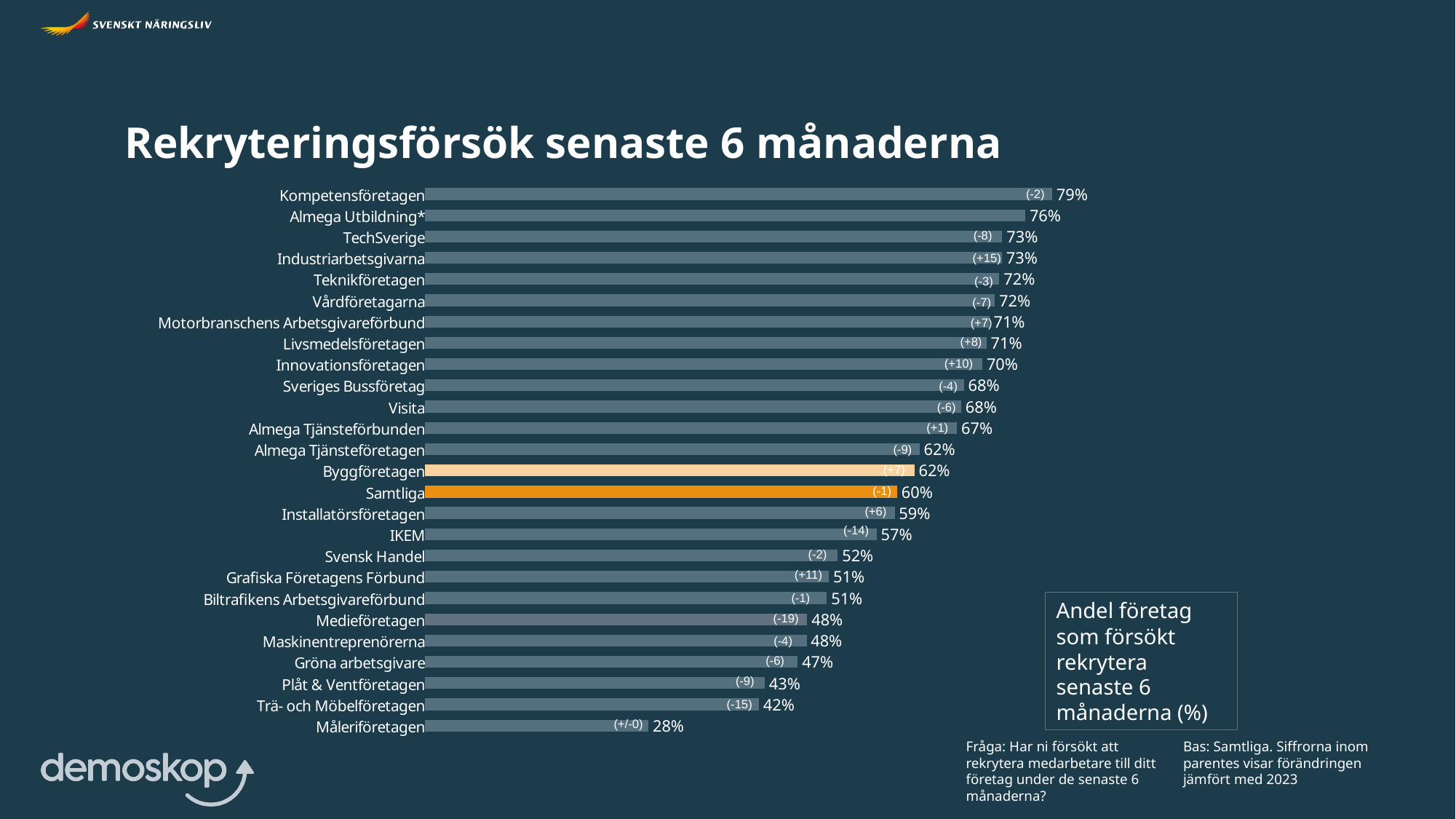
Which is larger, the value for Svensk Handel or the value for Gröna arbetsgivare? Svensk Handel What is the title of the chart? Rekryteringsförsök senaste 6 månaderna What is the value for IKEM? 57% What change compared to 2023 is shown in parentheses for Industriarbetsgivarna? +15 What is the value for Måleriföretagen? 28% What is the difference between the values for Kompetensföretagen and Måleriföretagen? 51 percentage points What kind of chart is shown on the slide? Bar chart What is the value for Samtliga? 60% Which category's bar is highlighted in dark orange? Samtliga How many categories are shown in the chart? 26 Which category has the highest value? Kompetensföretagen Which category has the lowest value? Måleriföretagen